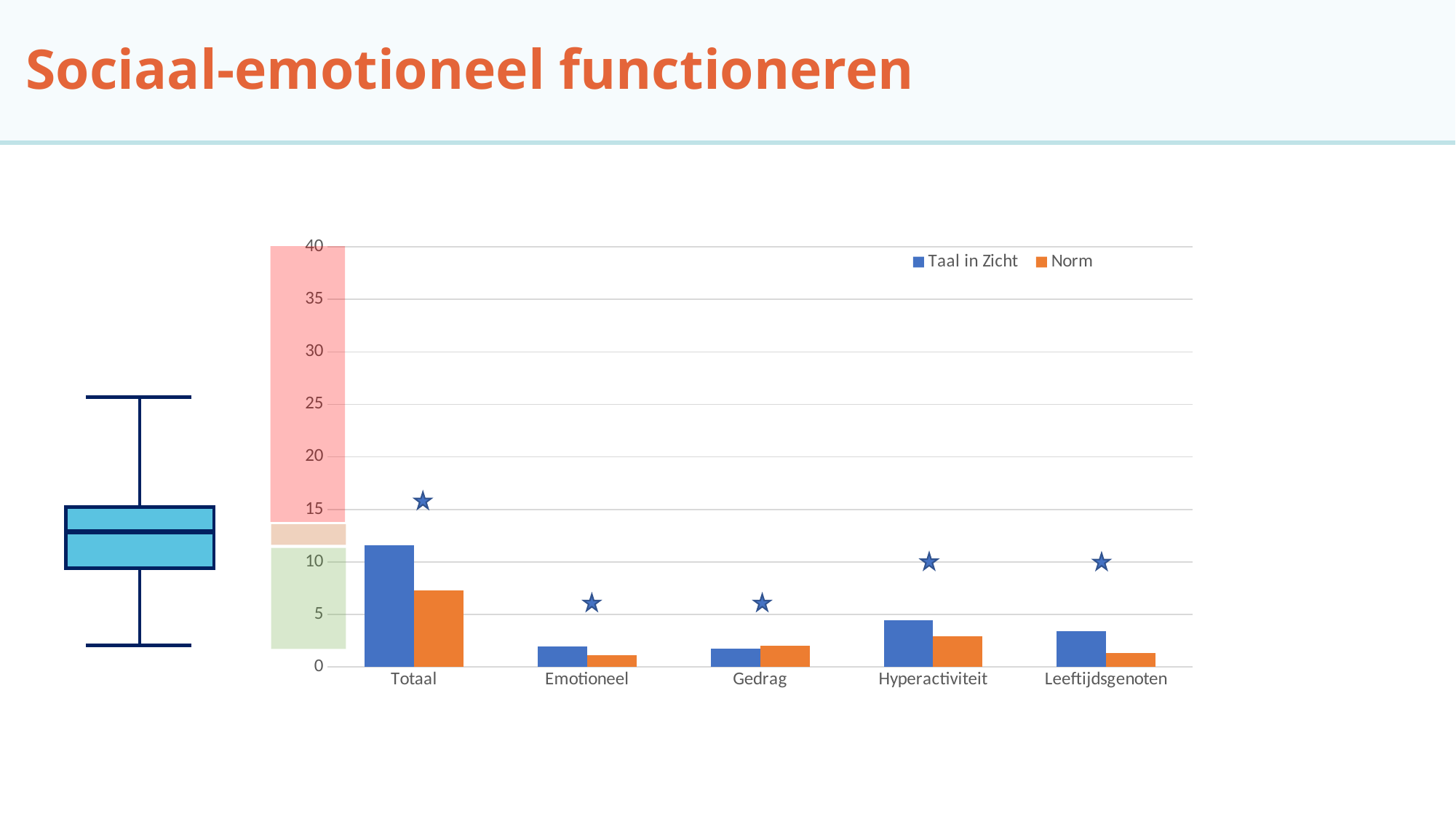
For Totaal, which series has the larger value, Taal in Zicht or Norm? Taal in Zicht Which category has the highest value for the Taal in Zicht series? Totaal What is the title of the slide containing the chart? Sociaal-emotioneel functioneren How many series does the chart legend list? 2 Is the Norm value for Totaal greater or less than 10? less What kind of chart is shown on the slide? bar chart Is the Taal in Zicht value for Totaal greater or less than 10? greater Which series is shown in orange in the chart legend? Norm Which category has the highest value for the Norm series? Totaal For Leeftijdsgenoten, which series has the larger value, Taal in Zicht or Norm? Taal in Zicht How many categories are shown on the x axis of the chart? 5 Is the Taal in Zicht value for Hyperactiviteit greater or less than 5? less